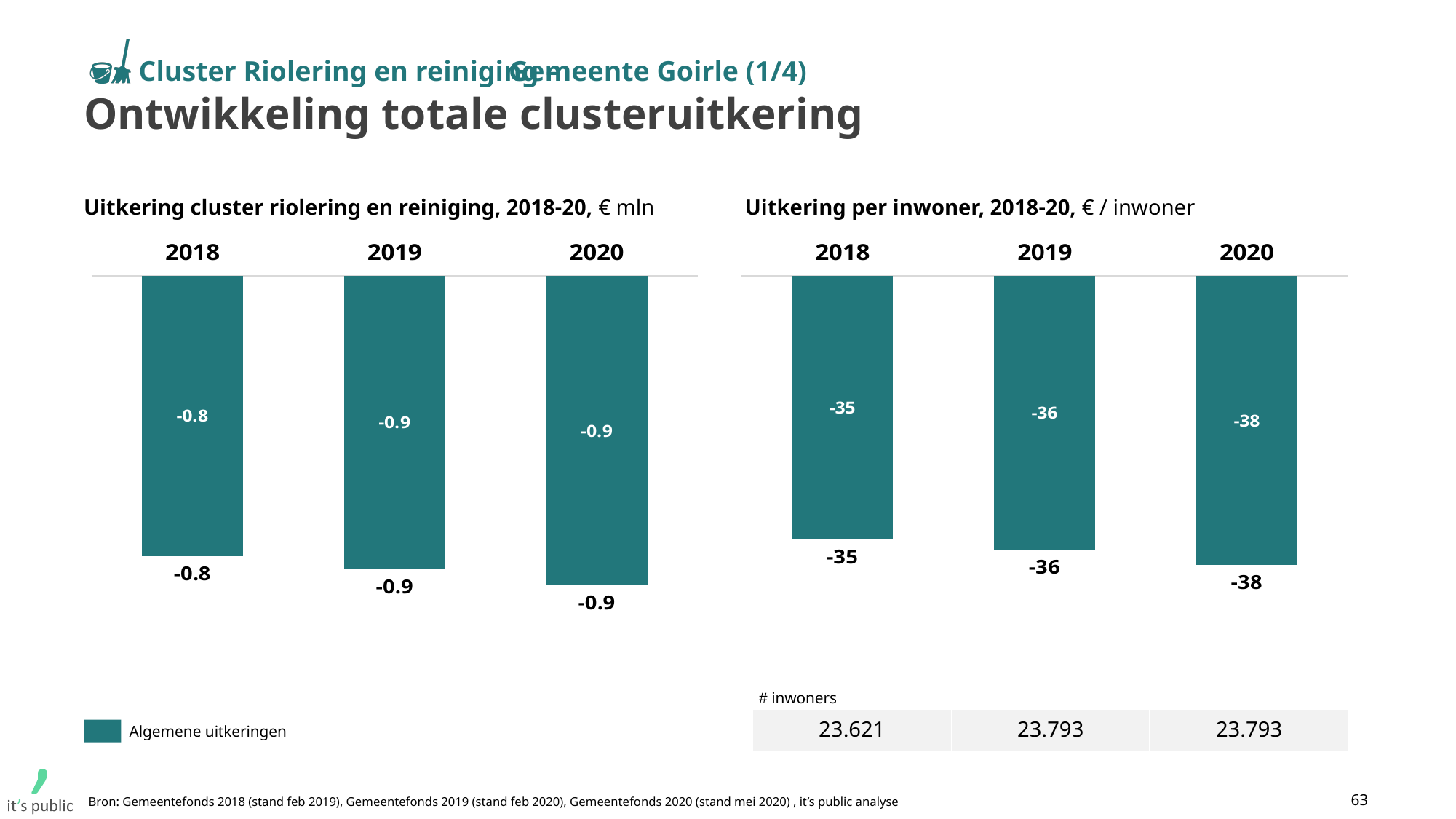
In the chart 'Uitkering per inwoner, 2018-20', which year has the highest value? 2018 What kind of chart is 'Uitkering cluster riolering en reiniging, 2018-20'? Bar chart In the chart 'Uitkering per inwoner, 2018-20', do the values rise or fall from 2018 to 2020? Fall In the chart 'Uitkering per inwoner, 2018-20', what is the value for 2019? -36 In the chart 'Uitkering cluster riolering en reiniging, 2018-20', what is the value for 2020? -0.9 In the chart 'Uitkering cluster riolering en reiniging, 2018-20', what is the value for 2018? -0.8 In the chart 'Uitkering cluster riolering en reiniging, 2018-20', which is larger, the value for 2018 or the value for 2019? 2018 What series name does the legend on the slide show? Algemene uitkeringen In the chart 'Uitkering per inwoner, 2018-20', which year has the lowest value? 2020 How many years are shown in the chart 'Uitkering per inwoner, 2018-20'? 3 In the chart 'Uitkering per inwoner, 2018-20', what is the value for 2020? -38 In the chart 'Uitkering per inwoner, 2018-20', what is the difference between the 2018 and 2020 values? 3